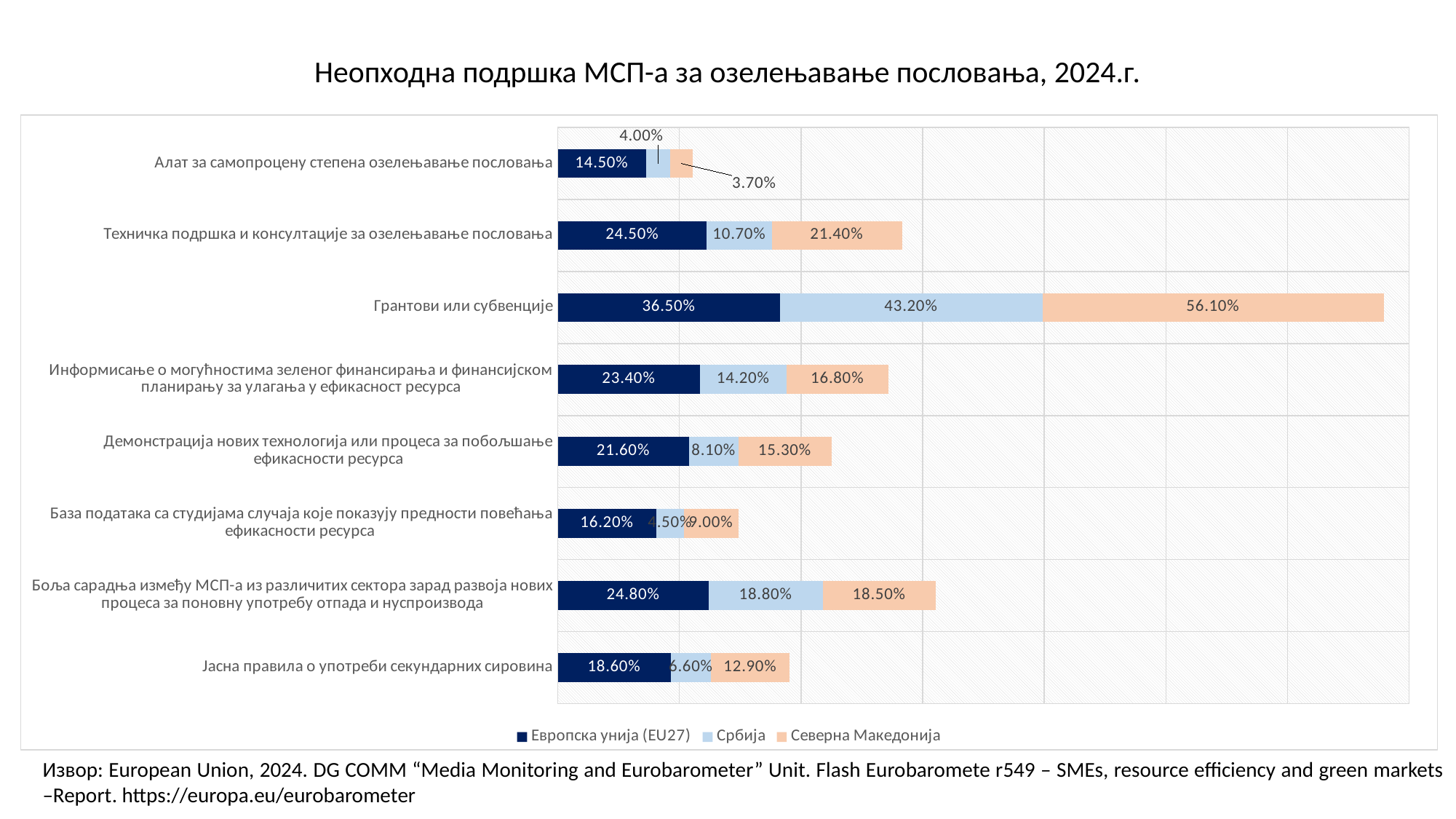
Which category has the lowest value for Европска унија (EU27)? Алат за самопроцену степена озелењавање пословања How many series does the legend list? 3 What is the value for Србија for Јасна правила о употреби секундарних сировина? 6.60% For Демонстрација нових технологија или процеса за побољшање ефикасности ресурса, which is larger: the value for Србија or for Северна Македонија? Северна Македонија How many categories are shown on the chart? 8 What is the total of the stacked bar for Грантови или субвенције? 135.80% What is the value for Европска унија (EU27) for Грантови или субвенције? 36.50% What kind of chart is shown on the slide? Stacked bar chart What is the difference between the Северна Македонија and Европска унија (EU27) values for Грантови или субвенције? 19.60% Which category has the highest value for Северна Македонија? Грантови или субвенције What is the title of the chart? Неопходна подршка МСП-а за озелењавање пословања, 2024.г. What is the value for Северна Македонија for Техничка подршка и консултације за озелењавање пословања? 21.40%